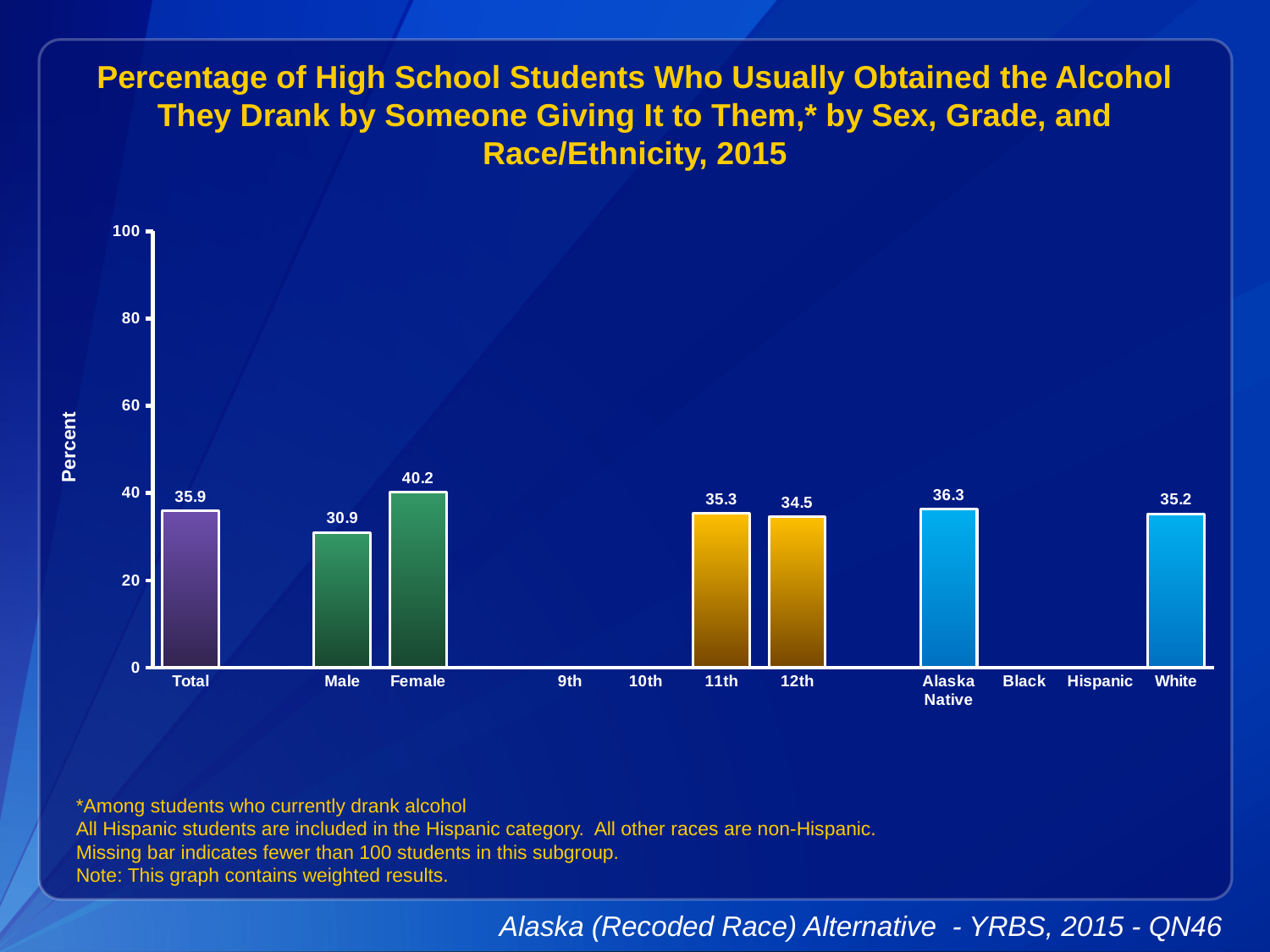
What is the value for Alaska Native? 36.3 How many categories have a plotted bar? 7 What is the value for 12th grade? 34.5 What is the difference between the Female and Male values? 9.3 Which category has the highest value? Female Which category with a plotted bar has the lowest value? Male What is the value for Female? 40.2 Is the value for Total greater or less than 40? less What kind of chart is shown? bar chart Which is larger, the value for 11th grade or 12th grade? 11th What is the value for Male? 30.9 What is the label on the vertical axis? Percent